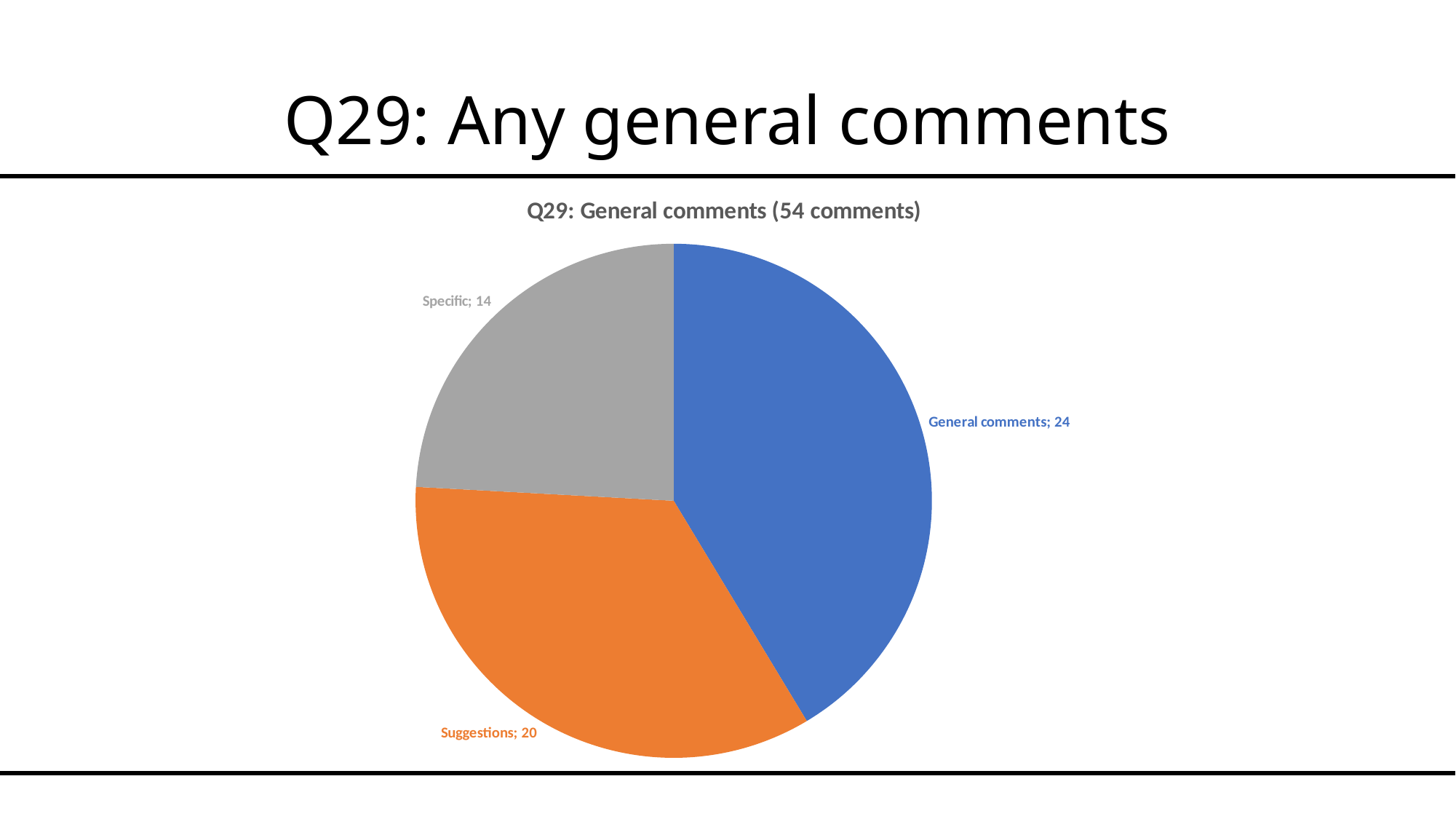
Which is larger, Suggestions or Specific? Suggestions What is the difference between Suggestions and Specific? 6 What is the difference between General comments and Specific? 10 How many slices does the pie chart have? 3 What is the value for Specific? 14 What is the value for General comments? 24 What kind of chart is shown? Pie chart What is the value for Suggestions? 20 Which category has the smallest slice? Specific Which category has the largest slice? General comments What is the total of all slices? 58 What is the title of the chart? Q29: General comments (54 comments)